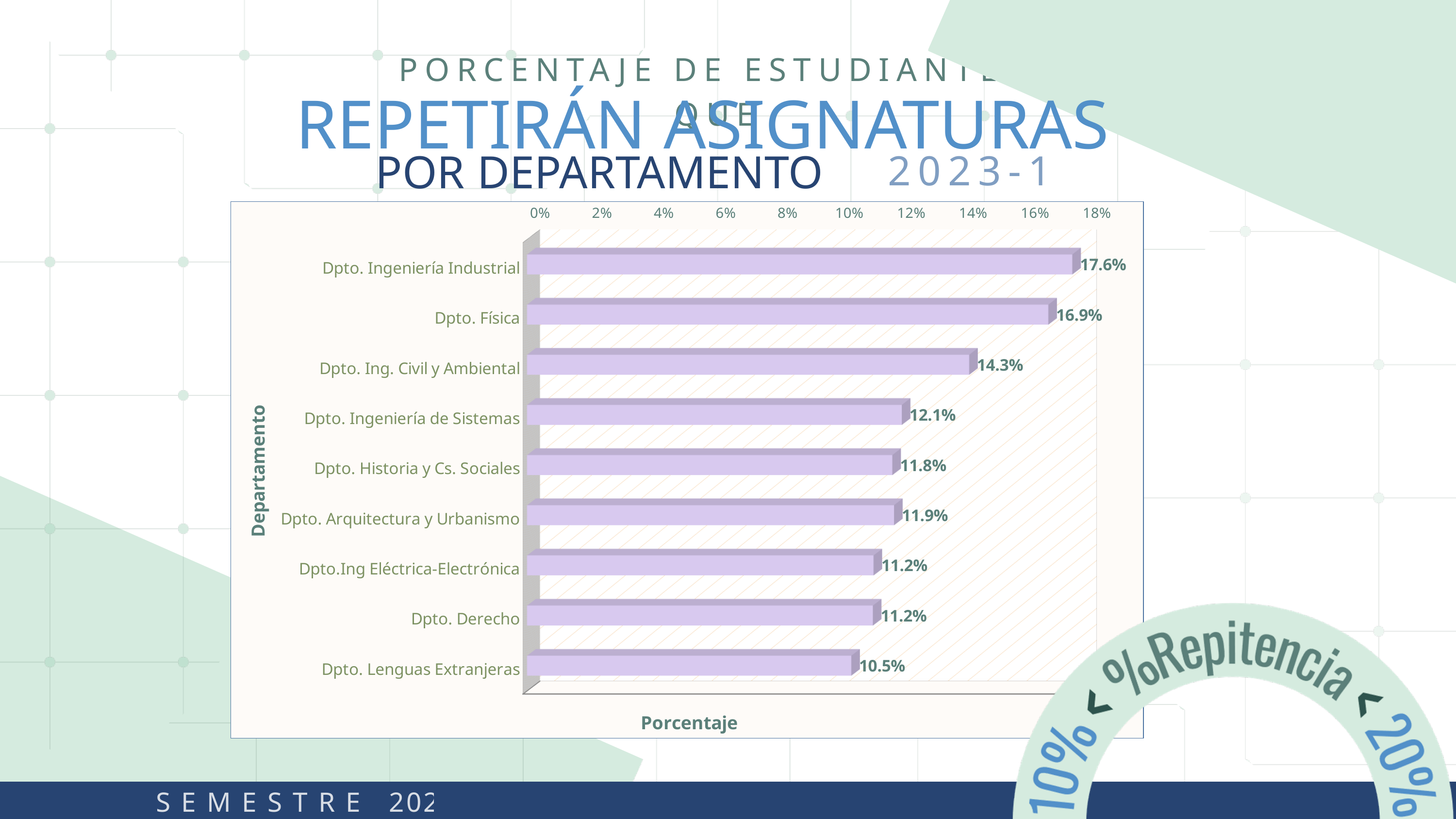
Which department has the lowest percentage? Dpto. Lenguas Extranjeras What is the value for Dpto. Ingeniería Industrial? 17.6% What is the value for Dpto. Lenguas Extranjeras? 10.5% Which department has the highest percentage? Dpto. Ingeniería Industrial What is the difference between Dpto. Ing. Civil y Ambiental and Dpto. Ingeniería de Sistemas? 2.2% Which is larger, the value for Dpto. Física or the value for Dpto. Ingeniería de Sistemas? Dpto. Física What kind of chart is shown on the slide? Bar chart How many departments are shown in the chart? 9 What is the difference between Dpto. Ingeniería Industrial and Dpto. Física? 0.7% What is the value for Dpto. Historia y Cs. Sociales? 11.8% What is the label of the horizontal axis? Porcentaje What is the value for Dpto. Ing. Civil y Ambiental? 14.3%